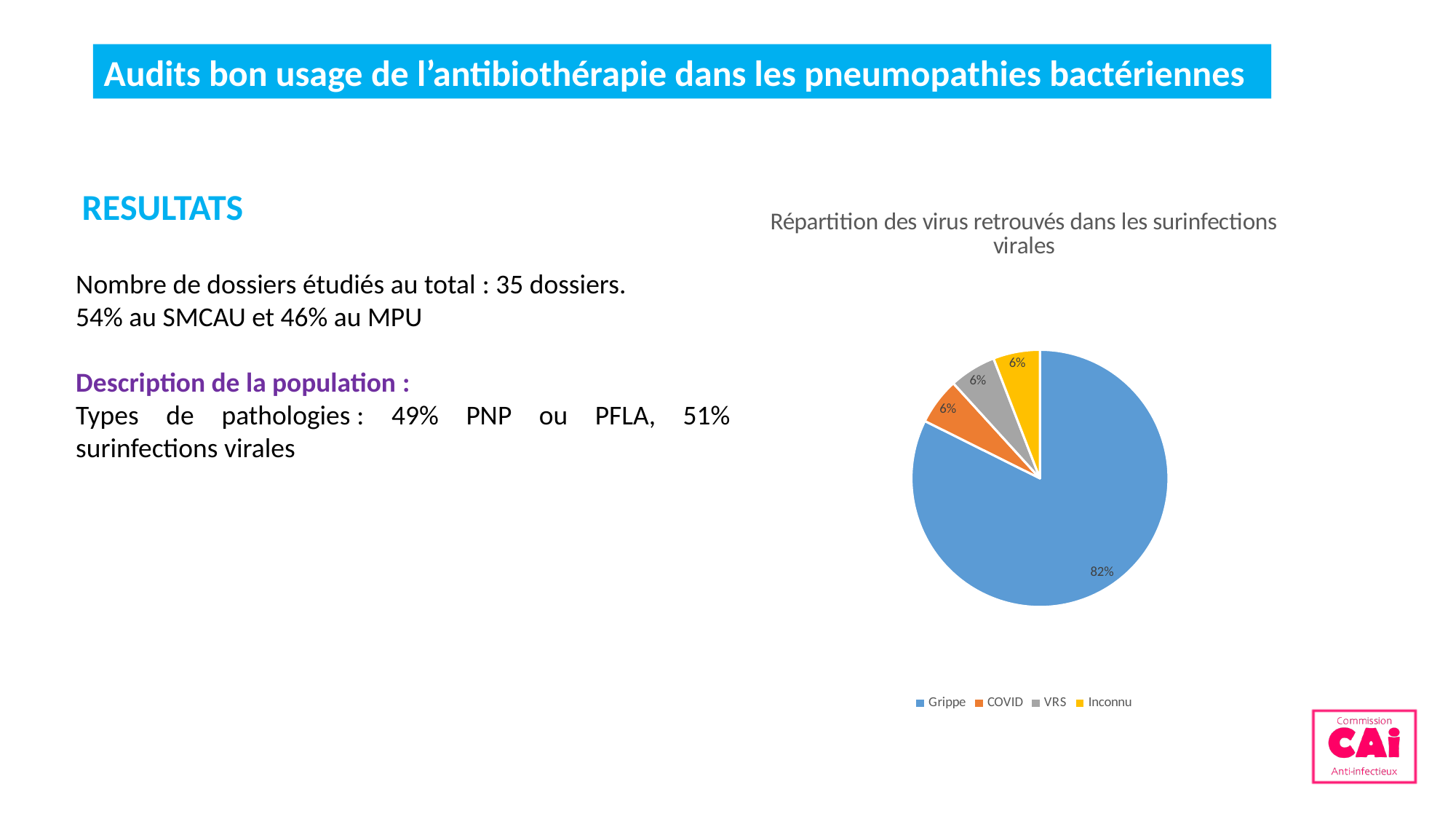
Which colour is used for the Inconnu slice? yellow What share of the pie does VRS represent? 6% How many categories does the pie chart show? 4 What share of the pie does COVID represent? 6% Which category has the largest slice of the pie? Grippe What is the title of the chart? Répartition des virus retrouvés dans les surinfections virales Which is larger, the share for Grippe or the share for VRS? Grippe What is the difference between the share for Grippe and the share for COVID? 76% How many entries does the legend list? 4 What kind of chart is shown on the slide? pie chart What share of the pie does Grippe represent? 82%